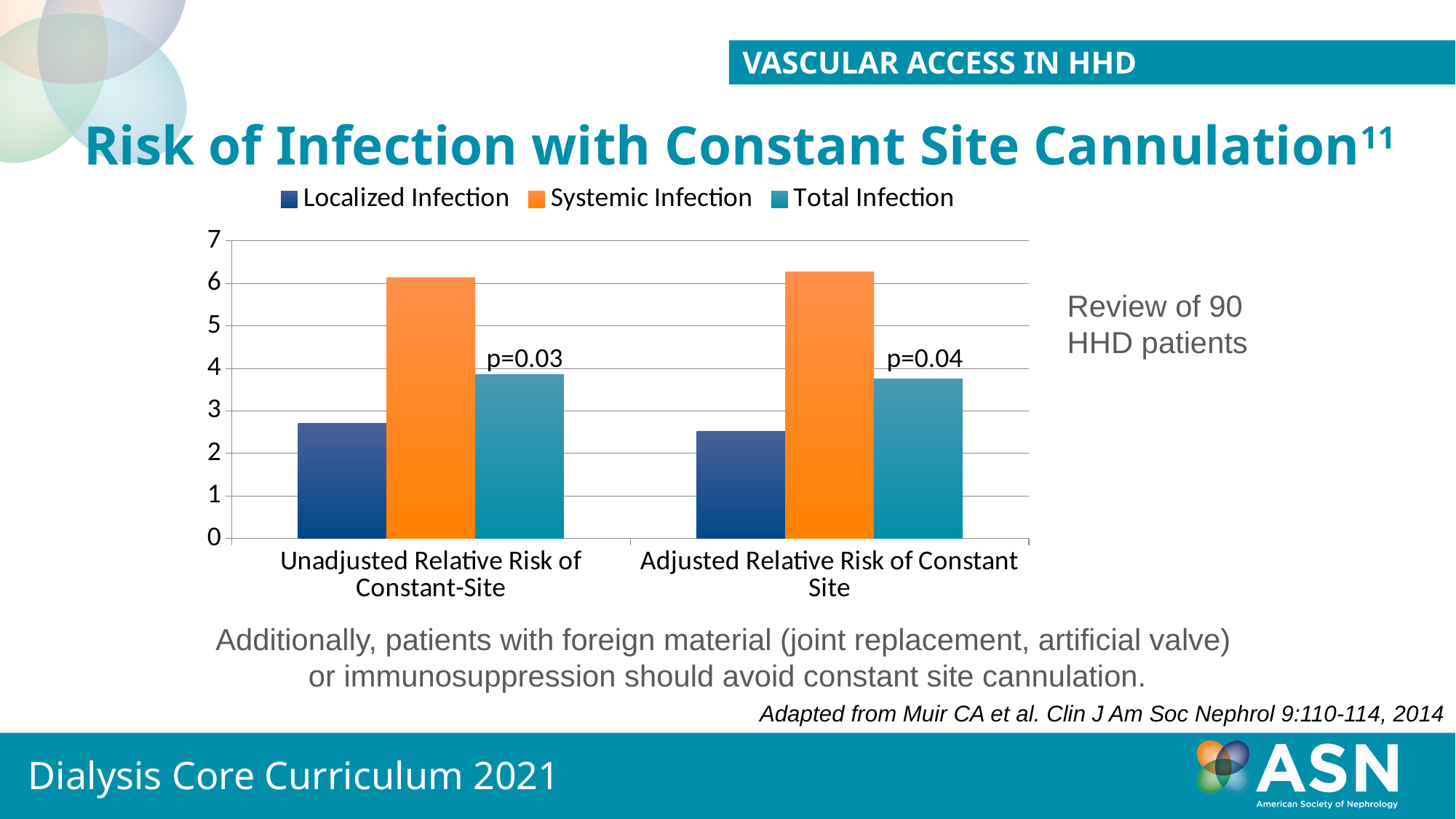
Is the value for Total Infection in the Unadjusted Relative Risk of Constant-Site category greater or less than 3? greater What p-value is printed above the Unadjusted Relative Risk of Constant-Site group? p=0.03 How many series does the chart legend list? 3 Which colour represents Systemic Infection in the chart legend? orange Is the value for Systemic Infection in the Unadjusted Relative Risk of Constant-Site category greater or less than 5? greater Which series has the highest bar in the Adjusted Relative Risk of Constant Site category? Systemic Infection Is the value for Localized Infection in the Adjusted Relative Risk of Constant Site category greater or less than 3? less Which series has the lowest bar in the Unadjusted Relative Risk of Constant-Site category? Localized Infection How many categories are shown on the x axis of the chart? 2 In the Unadjusted Relative Risk of Constant-Site category, which is larger: Systemic Infection or Localized Infection? Systemic Infection What kind of chart is shown on the slide? bar chart In the Adjusted Relative Risk of Constant Site category, which is larger: Total Infection or Localized Infection? Total Infection